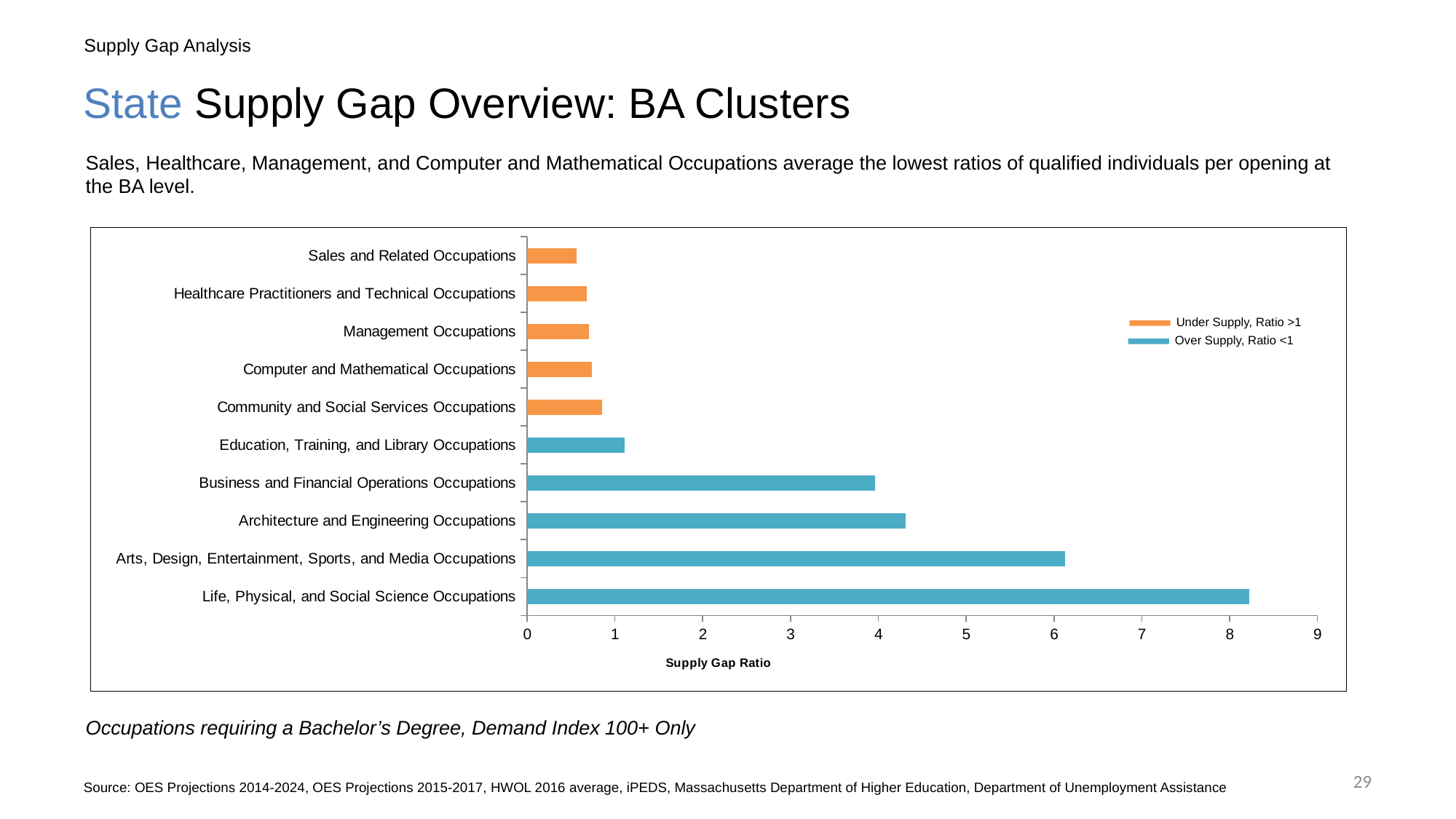
Is the supply gap ratio for Arts, Design, Entertainment, Sports, and Media Occupations greater or less than 6? greater Which has a larger supply gap ratio: Arts, Design, Entertainment, Sports, and Media Occupations or Architecture and Engineering Occupations? Arts, Design, Entertainment, Sports, and Media Occupations What is the title of the horizontal axis of the chart? Supply Gap Ratio Which occupation cluster has the lowest supply gap ratio? Sales and Related Occupations Which occupation cluster has the highest supply gap ratio? Life, Physical, and Social Science Occupations How many occupation clusters are shown in the chart? 10 Is the supply gap ratio for Life, Physical, and Social Science Occupations greater or less than 8? greater How many series does the legend list? 2 Is the supply gap ratio for Community and Social Services Occupations greater or less than 1? less Which has a larger supply gap ratio: Education, Training, and Library Occupations or Business and Financial Operations Occupations? Business and Financial Operations Occupations What kind of chart is shown on the slide? bar chart